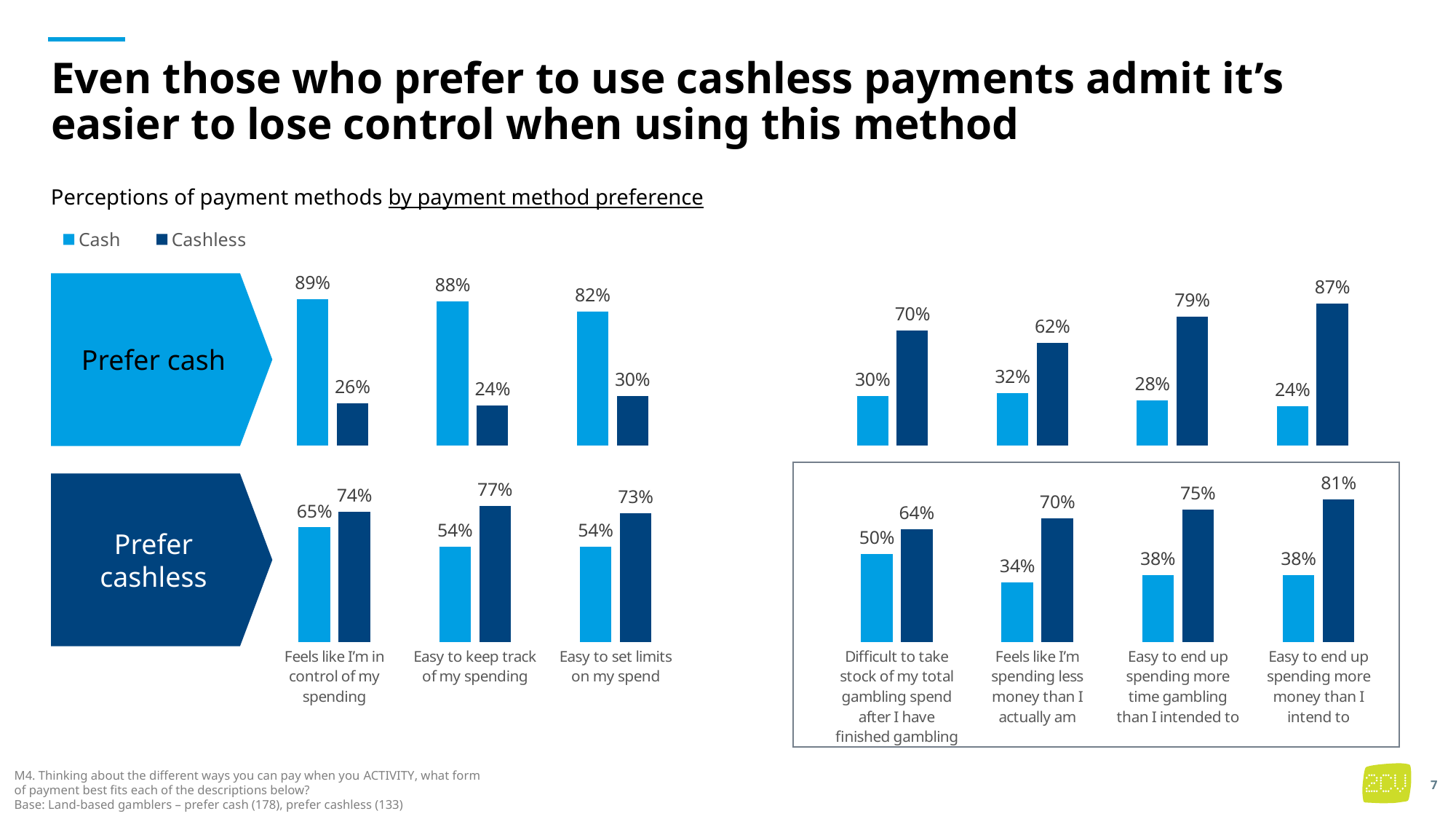
In the 'Prefer cashless' row, what is the Cashless value for 'Easy to end up spending more money than I intend to'? 81% In the 'Prefer cash' row, what is the Cash value for 'Feels like I'm in control of my spending'? 89% How many statements (categories) are shown along the bottom of the chart? 7 In the 'Prefer cashless' row, which is larger for 'Feels like I'm in control of my spending': the Cash value or the Cashless value? Cashless What kind of chart is shown on the slide? Bar chart In the 'Prefer cashless' row, what is the difference between the Cashless and Cash values for 'Feels like I'm spending less money than I actually am'? 36 percentage points In the 'Prefer cash' row, which statement has the highest Cashless value? Easy to end up spending more money than I intend to In the 'Prefer cash' row, what is the difference between the Cash and Cashless values for 'Easy to set limits on my spend'? 52 percentage points In the 'Prefer cash' row, what is the Cashless value for 'Easy to keep track of my spending'? 24% What are the two series named in the legend? Cash and Cashless How many series does the legend list? 2 In the 'Prefer cashless' row, which statement has the lowest Cash value? Feels like I'm spending less money than I actually am